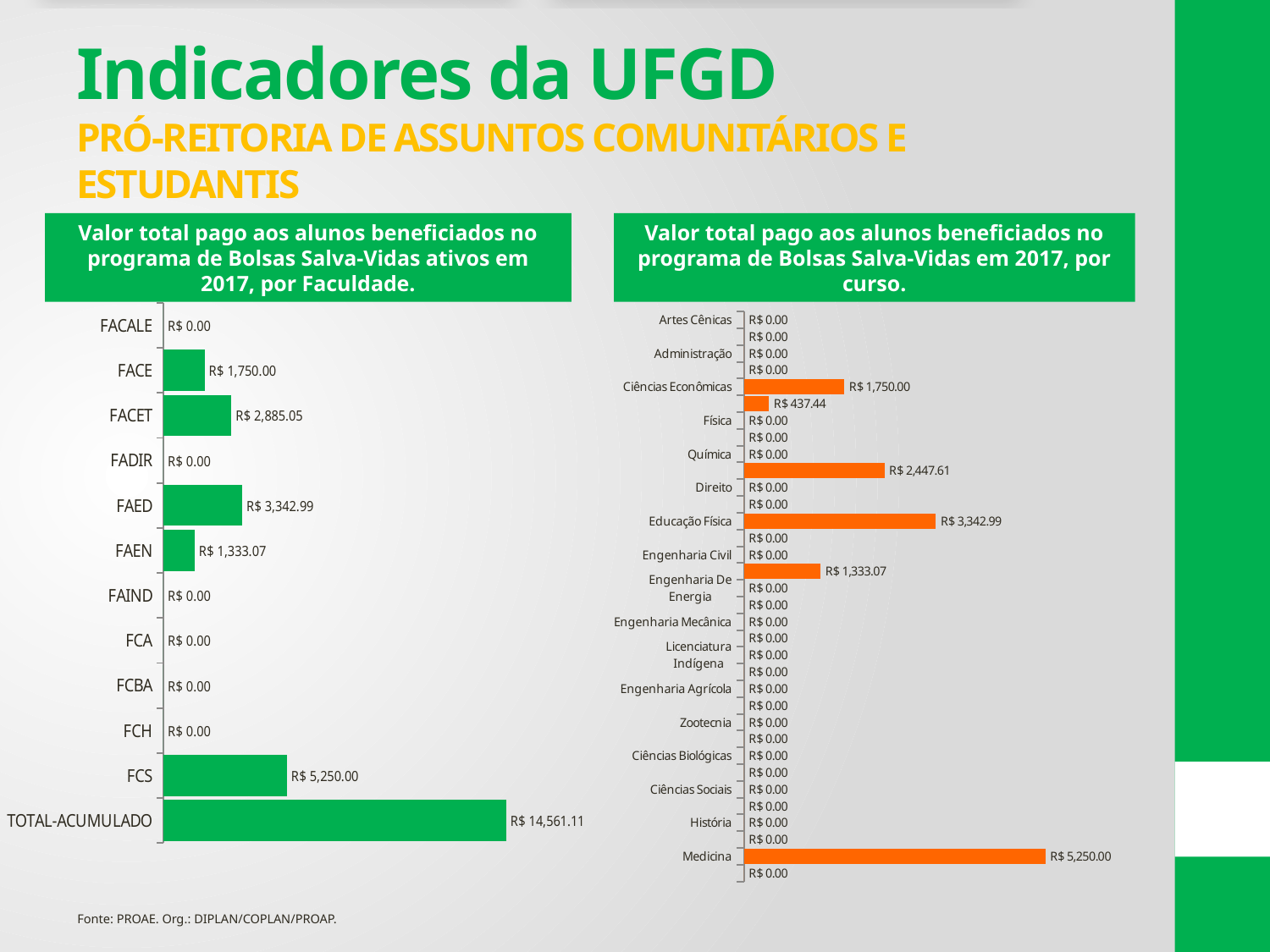
On the left chart (por Faculdade), what is the difference between FACET and FAEN? R$ 1,551.98 On the left chart (por Faculdade), what is the value for FAED? R$ 3,342.99 On the right chart (por curso), what is the value for Ciências Econômicas? R$ 1,750.00 On the right chart (por curso), what is the value for Medicina? R$ 5,250.00 On the right chart (por curso), what is the value for Educação Física? R$ 3,342.99 On the right chart (por curso), which is larger, Ciências Econômicas or Medicina? Medicina On the left chart (por Faculdade), which faculty (excluding TOTAL-ACUMULADO) has the highest value? FCS On the left chart (por Faculdade), what is the value for TOTAL-ACUMULADO? R$ 14,561.11 On the left chart (por Faculdade), how many categories are shown? 12 On the left chart (por Faculdade), which is larger, FACE or FAED? FAED On the left chart (por Faculdade), what is the value for FCS? R$ 5,250.00 On the left chart (por Faculdade), what type of chart is it? Bar chart